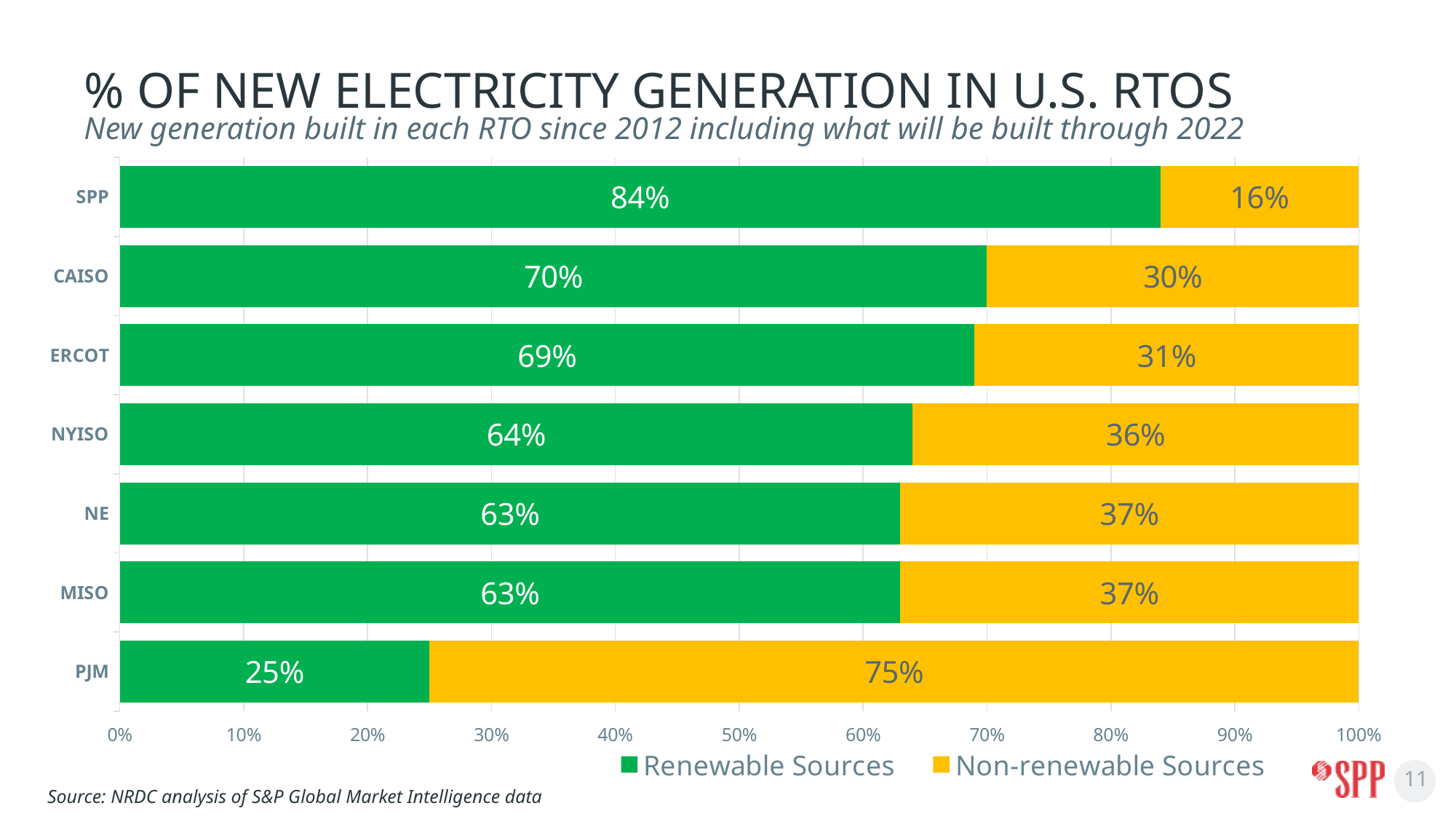
What is the difference between the Renewable Sources share of SPP and CAISO? 14% What is the Renewable Sources value for NYISO? 64% Which RTO has the lowest Renewable Sources share? PJM What is the total of the SPP bar (Renewable plus Non-renewable)? 100% Which colour represents Non-renewable Sources in the chart? Yellow Which has a larger Non-renewable Sources share, ERCOT or NYISO? NYISO What is the Non-renewable Sources share for PJM? 75% How many RTOs are shown on the chart? 7 What kind of chart is shown on the slide? Stacked bar chart What percentage of new generation in SPP comes from Renewable Sources? 84% Which RTO has the highest Renewable Sources share? SPP How many series does the legend list? 2